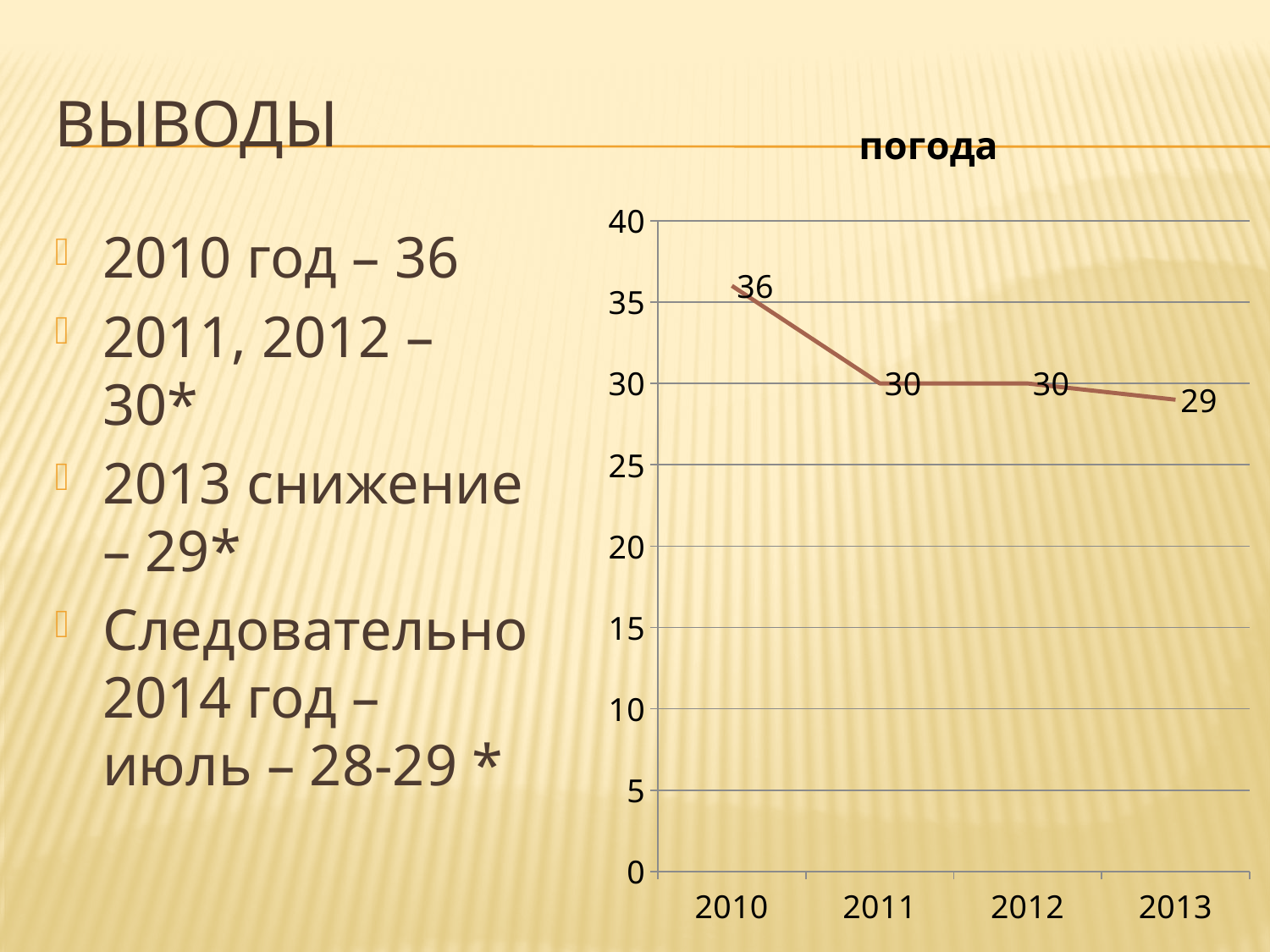
Do the values rise or fall from 2010 to 2013? fall Which is larger, the value for 2010 or the value for 2012? 2010 How many years are plotted on the x axis of the chart? 4 What is the difference between the values for 2010 and 2013? 7 Is the value for 2013 greater or less than 30? less What is the value for 2013 in the chart? 29 Which year has the lowest value in the chart? 2013 What is the value for 2011 in the chart? 30 What is the value for 2010 in the chart? 36 Which year has the highest value in the chart? 2010 What is the title of the chart? погода What kind of chart is shown on the slide? line chart